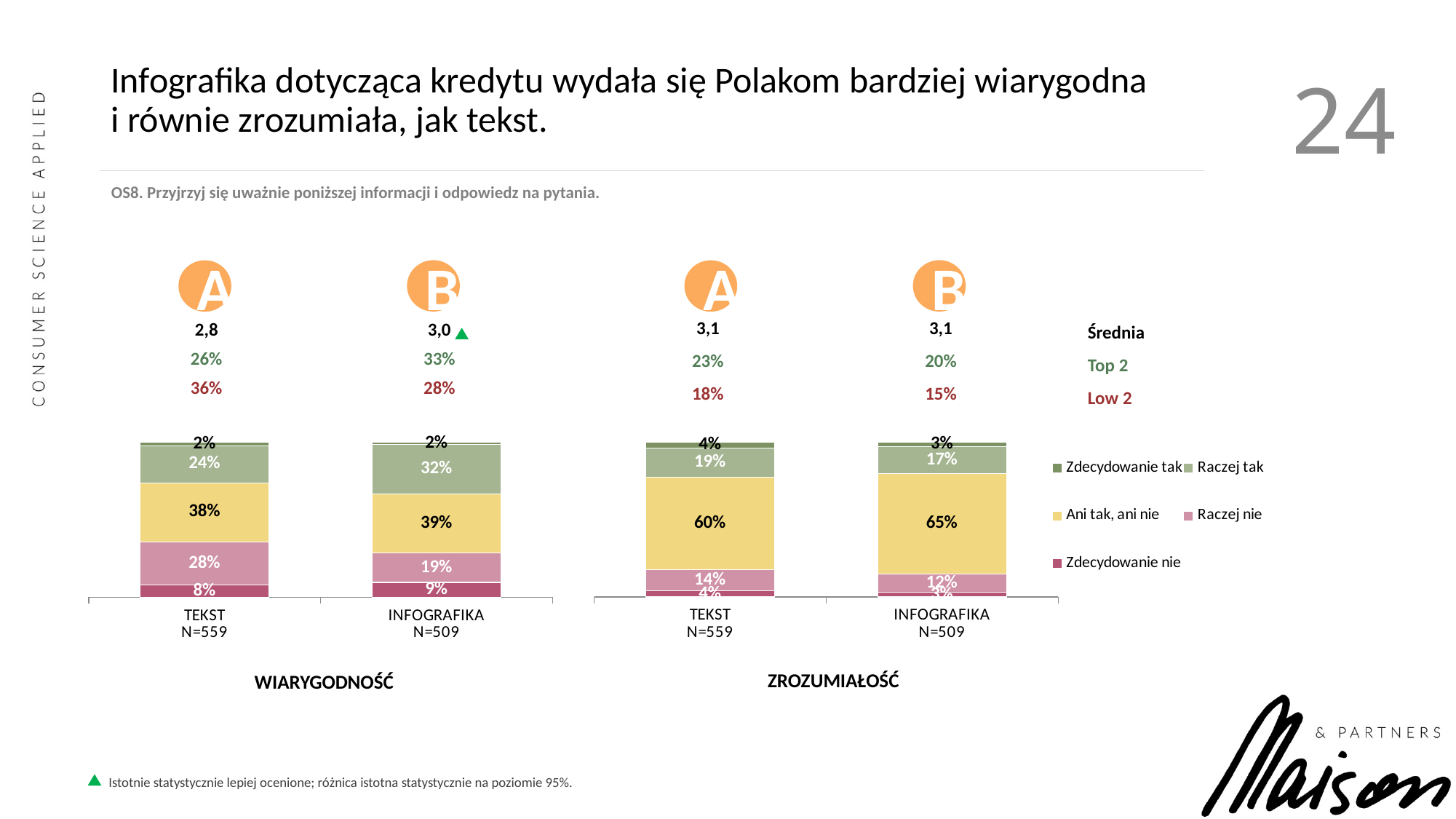
How many series does the legend list? 5 In the ZROZUMIAŁOŚĆ chart, what percentage of the TEKST bar is 'Raczej nie'? 14% How many bars are in the ZROZUMIAŁOŚĆ chart? 2 In the ZROZUMIAŁOŚĆ chart, what percentage of the INFOGRAFIKA bar is 'Ani tak, ani nie'? 65% In the ZROZUMIAŁOŚĆ chart, which bar has the larger 'Ani tak, ani nie' segment, TEKST or INFOGRAFIKA? INFOGRAFIKA In the WIARYGODNOŚĆ chart, which bar has the larger 'Raczej tak' segment, TEKST or INFOGRAFIKA? INFOGRAFIKA What is the mean (Średnia) shown for TEKST in the WIARYGODNOŚĆ chart? 2,8 What is the Top 2 value shown for INFOGRAFIKA in the WIARYGODNOŚĆ chart? 33% What kind of chart is the WIARYGODNOŚĆ chart? Stacked bar chart In the WIARYGODNOŚĆ chart, what percentage of the INFOGRAFIKA bar is 'Raczej tak'? 32% In the WIARYGODNOŚĆ chart, what is the difference between the 'Raczej nie' shares for TEKST and INFOGRAFIKA? 9 percentage points In the WIARYGODNOŚĆ chart, what percentage of the TEKST bar is 'Ani tak, ani nie'? 38%